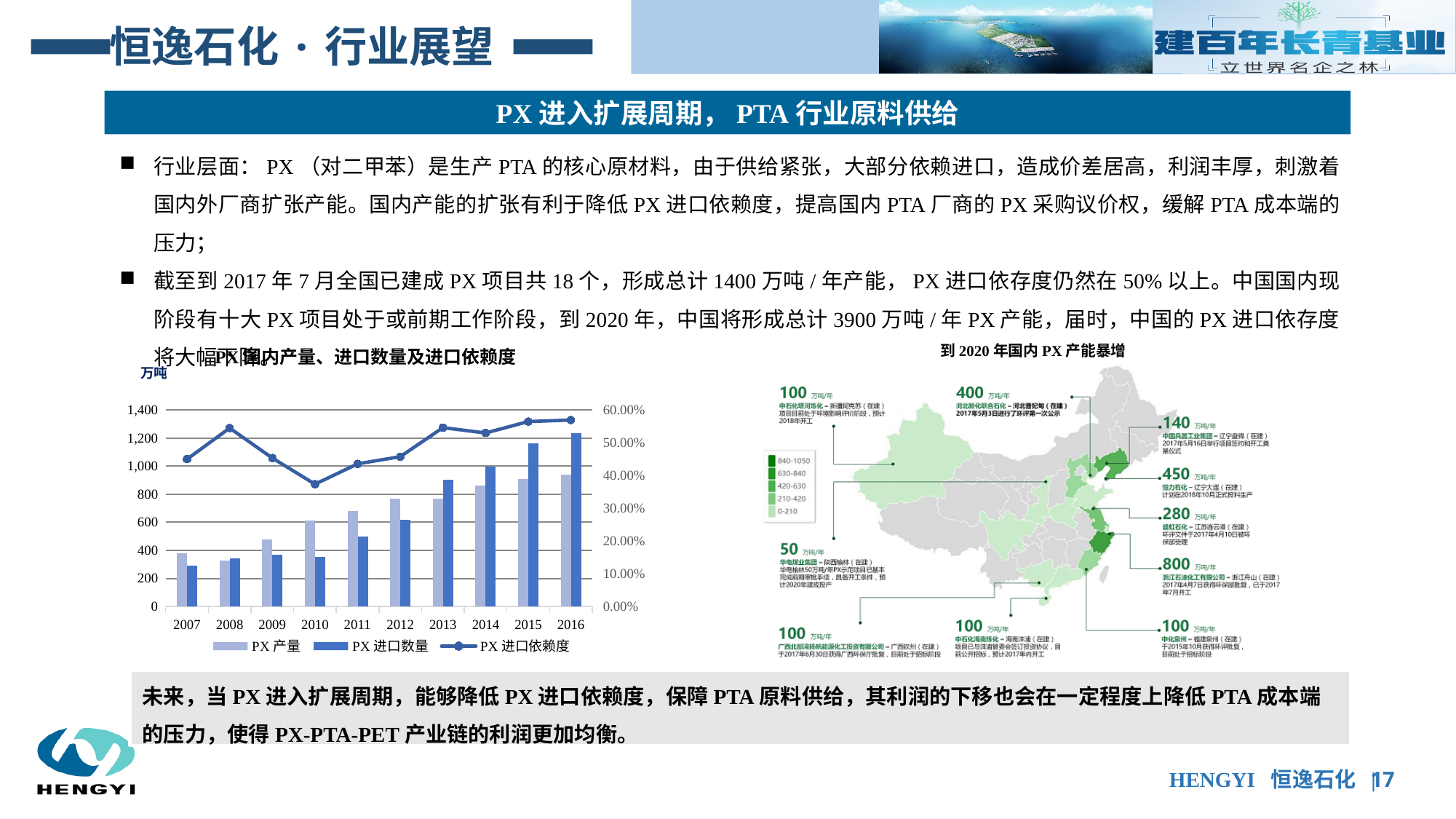
What kind of chart is "PX 国内产量、进口数量及进口依赖度"? Combined bar and line chart What unit is shown on the left axis of the "PX 国内产量、进口数量及进口依赖度" chart? 万吨 In the "PX 国内产量、进口数量及进口依赖度" chart, is the PX 进口依赖度 for 2010 greater or less than 40.00%? less In the "PX 国内产量、进口数量及进口依赖度" chart, is the PX 进口数量 for 2016 greater or less than 1,000? greater In the "PX 国内产量、进口数量及进口依赖度" chart, which year has the highest PX 进口数量? 2016 In the "PX 国内产量、进口数量及进口依赖度" chart, is the PX 产量 for 2010 greater or less than 800? less In the "PX 国内产量、进口数量及进口依赖度" chart, does PX 产量 generally rise or fall from 2007 to 2016? Rise How many years are shown on the x axis of the "PX 国内产量、进口数量及进口依赖度" chart? 10 In the "PX 国内产量、进口数量及进口依赖度" chart, which year has the lowest PX 进口依赖度? 2010 In the "PX 国内产量、进口数量及进口依赖度" chart, which year has the lowest PX 进口数量? 2007 How many series does the legend of the "PX 国内产量、进口数量及进口依赖度" chart list? 3 In the "PX 国内产量、进口数量及进口依赖度" chart, which is larger in 2016: PX 产量 or PX 进口数量? PX 进口数量